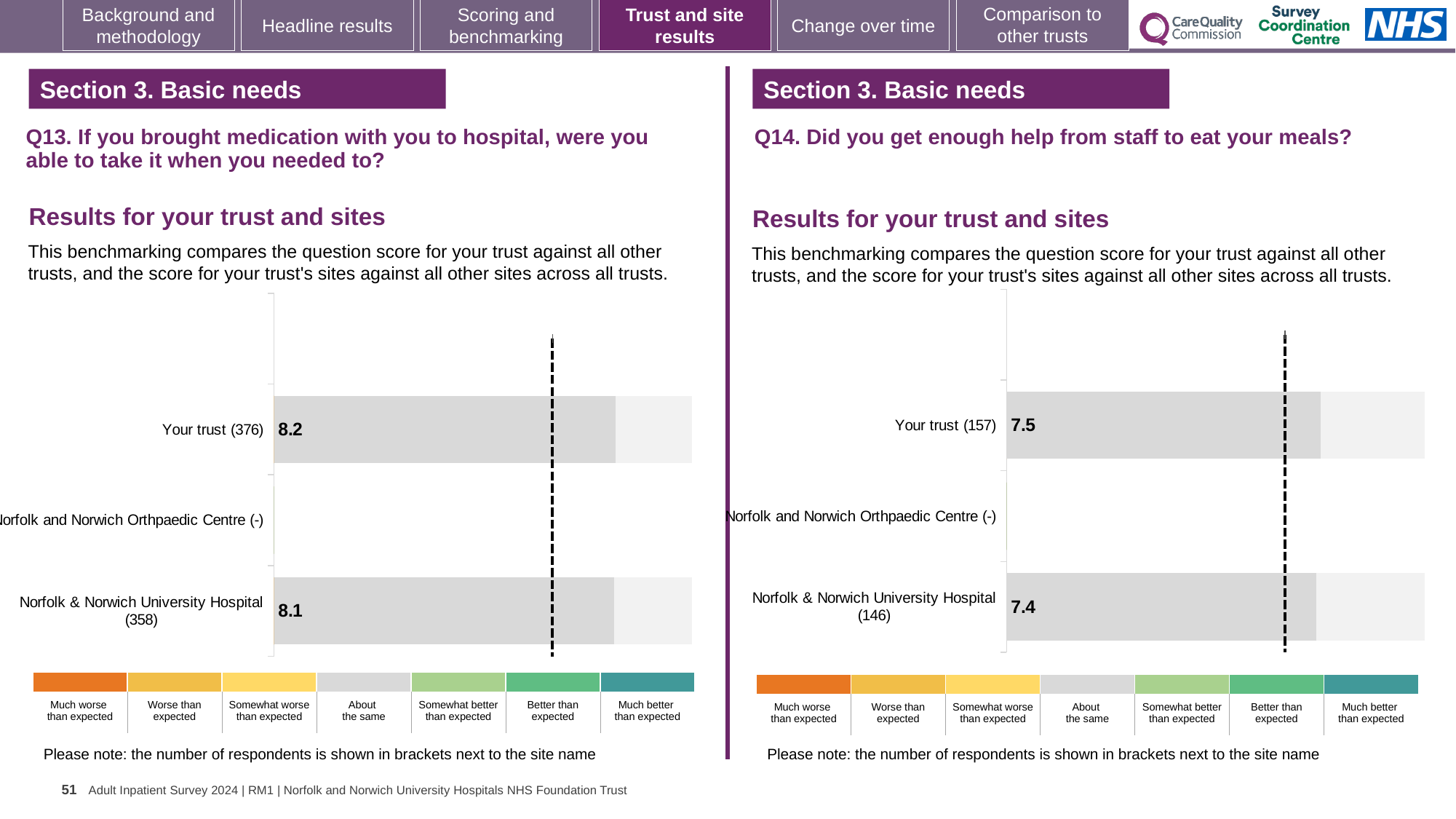
On the Q13 chart (left), what is the difference between the score for Your trust and the score for Norfolk & Norwich University Hospital? 0.1 How many categories are listed on the Q13 chart (left)? 3 On the Q14 chart (right), which has the higher score: Your trust or Norfolk & Norwich University Hospital? Your trust On the Q13 chart (left), which has the higher score: Your trust or Norfolk & Norwich University Hospital? Your trust On the Q13 chart (left), what is the score for Your trust (376)? 8.2 On the Q14 chart (right), what is the score for Norfolk & Norwich University Hospital (146)? 7.4 On the Q13 chart (left), what is the score for Norfolk & Norwich University Hospital (358)? 8.1 On the Q14 chart (right), which category has no score shown? Norfolk and Norwich Orthpaedic Centre (-) On the Q14 chart (right), what is the score for Your trust (157)? 7.5 On the Q13 chart (left), how many respondents are shown for Your trust? 376 What kind of chart is used on the Q14 chart (right)? Bar chart On the Q14 chart (right), what is the difference between the score for Your trust and the score for Norfolk & Norwich University Hospital? 0.1